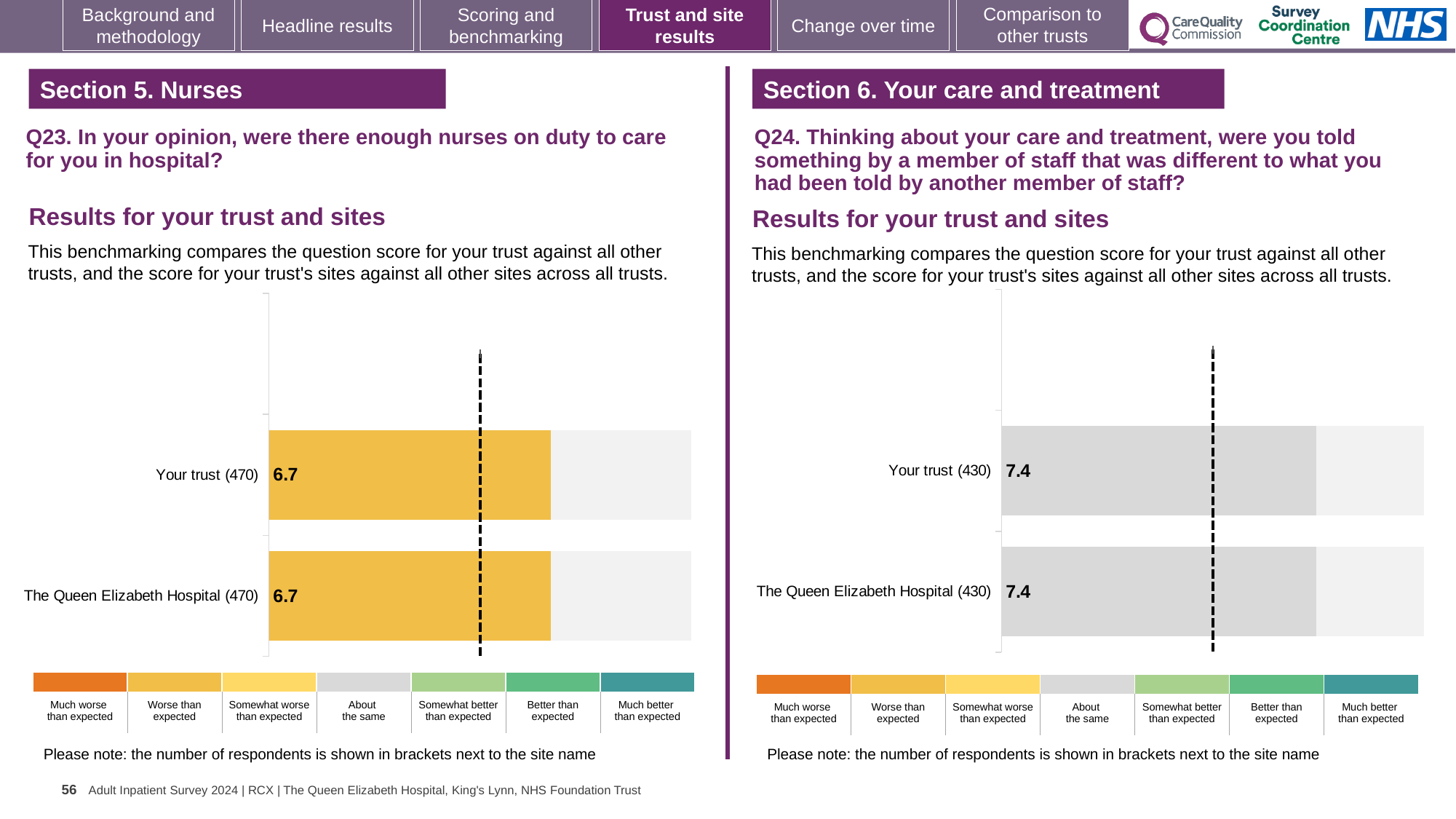
In the Q24 chart on the right, what is the score for The Queen Elizabeth Hospital? 7.4 In the Q23 chart on the left, what is the score for The Queen Elizabeth Hospital? 6.7 In the Q24 chart on the right, how many respondents are shown in brackets for The Queen Elizabeth Hospital? 430 In the Q23 chart on the left, how many respondents are shown in brackets for Your trust? 470 In the Q24 chart on the right, what is the score for Your trust? 7.4 How many bars are plotted in the Q24 chart on the right? 2 What kind of chart is the Q23 chart on the left? Bar chart How many categories does the colour key below the Q24 chart on the right list? 7 In the Q23 chart on the left, what is the score for Your trust? 6.7 In the Q24 chart on the right, what is the difference between the score for Your trust and the score for The Queen Elizabeth Hospital? 0 In the Q23 chart on the left, what is the difference between the score for Your trust and the score for The Queen Elizabeth Hospital? 0 How many bars are plotted in the Q23 chart on the left? 2